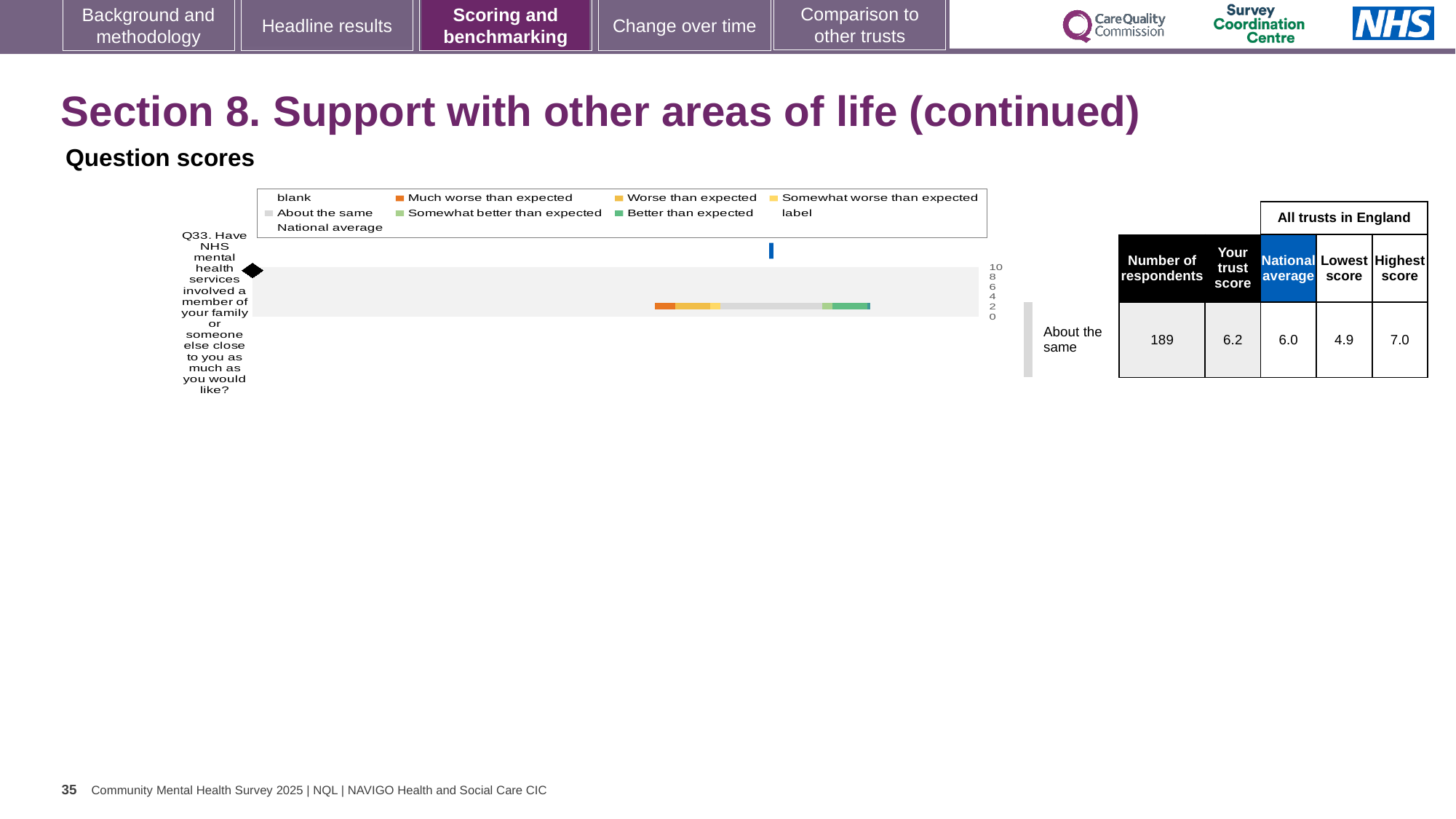
What is the number of respondents for Q33 in the table? 189 What benchmark category label is shown next to the chart for Q33? About the same Which question number is plotted in the chart? Q33 How many questions (categories) are plotted in the chart? 1 What kind of chart is shown on the slide? bar chart What is the difference between the highest and lowest scores among all trusts in England for Q33? 2.1 What is the national average score for Q33? 6.0 What is the lowest score among all trusts in England for Q33? 4.9 What is the trust's score for Q33? 6.2 Which is larger for Q33, the trust's score or the national average? the trust's score How many entries does the chart legend list? 9 What is the highest score among all trusts in England for Q33? 7.0